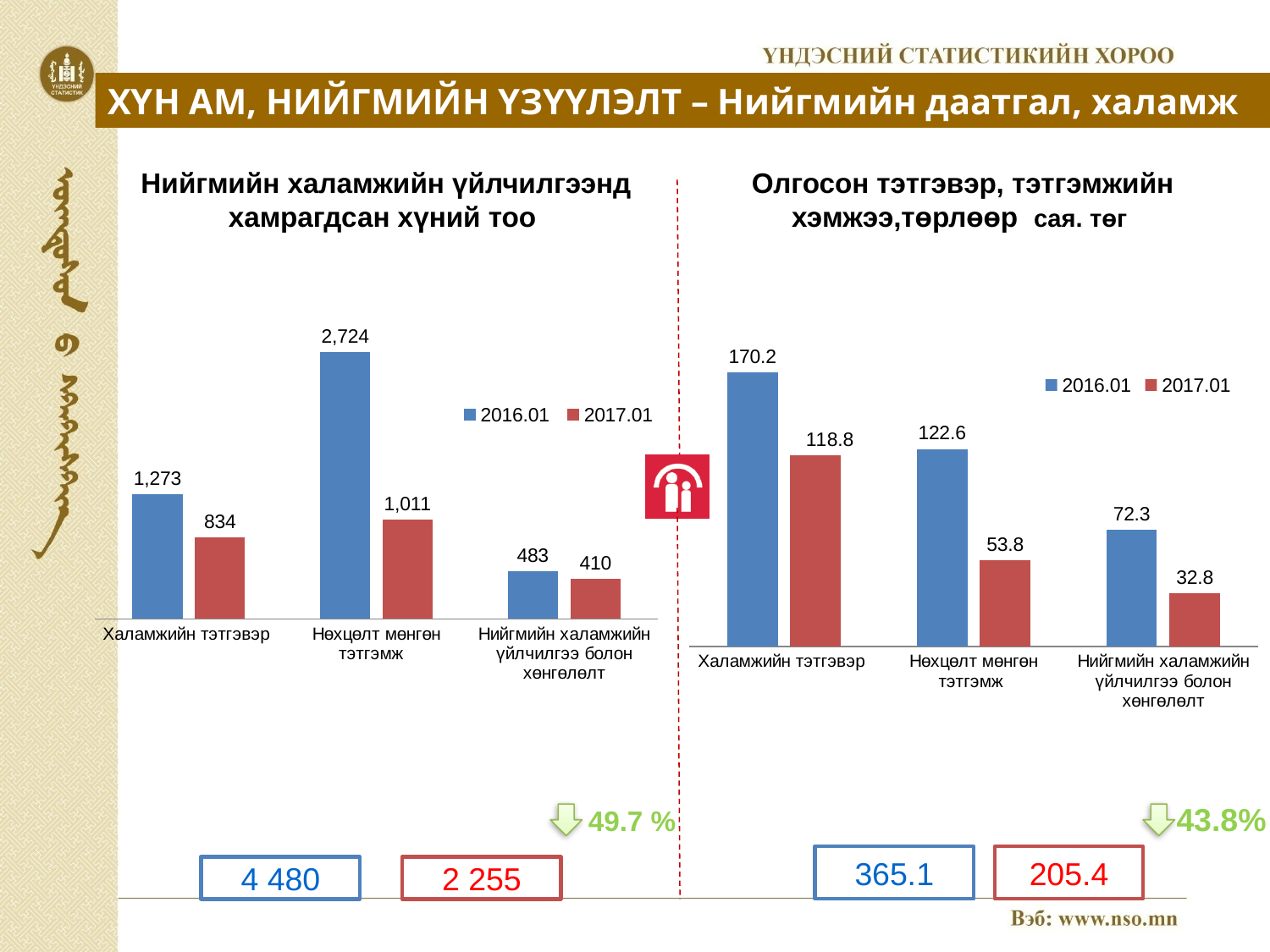
In the right chart (Олгосон тэтгэвэр, тэтгэмжийн хэмжээ, төрлөөр сая. төг), what is the 2017.01 value for Нийгмийн халамжийн үйлчилгээ болон хөнгөлөлт? 32.8 In the left chart (Нийгмийн халамжийн үйлчилгээнд хамрагдсан хүний тоо), which category has the lowest 2017.01 value? Нийгмийн халамжийн үйлчилгээ болон хөнгөлөлт In the left chart (Нийгмийн халамжийн үйлчилгээнд хамрагдсан хүний тоо), what is the 2016.01 value for Нөхцөлт мөнгөн тэтгэмж? 2,724 In the left chart (Нийгмийн халамжийн үйлчилгээнд хамрагдсан хүний тоо), what is the difference between the 2016.01 and 2017.01 values for Халамжийн тэтгэвэр? 439 In the left chart (Нийгмийн халамжийн үйлчилгээнд хамрагдсан хүний тоо), which category has the highest 2016.01 value? Нөхцөлт мөнгөн тэтгэмж In the right chart (Олгосон тэтгэвэр, тэтгэмжийн хэмжээ, төрлөөр сая. төг), what is the 2016.01 value for Халамжийн тэтгэвэр? 170.2 What type of chart is the right chart (Олгосон тэтгэвэр, тэтгэмжийн хэмжээ, төрлөөр сая. төг)? Bar chart In the right chart (Олгосон тэтгэвэр, тэтгэмжийн хэмжээ, төрлөөр сая. төг), what is the difference between the 2016.01 and 2017.01 values for Нөхцөлт мөнгөн тэтгэмж? 68.8 In the left chart (Нийгмийн халамжийн үйлчилгээнд хамрагдсан хүний тоо), how many categories are shown on the x axis? 3 In the right chart (Олгосон тэтгэвэр, тэтгэмжийн хэмжээ, төрлөөр сая. төг), which is larger: the 2017.01 value for Халамжийн тэтгэвэр or the 2016.01 value for Нөхцөлт мөнгөн тэтгэмж? 2016.01 value for Нөхцөлт мөнгөн тэтгэмж In the left chart (Нийгмийн халамжийн үйлчилгээнд хамрагдсан хүний тоо), what is the 2017.01 value for Халамжийн тэтгэвэр? 834 In the right chart (Олгосон тэтгэвэр, тэтгэмжийн хэмжээ, төрлөөр сая. төг), how many series does the legend list? 2